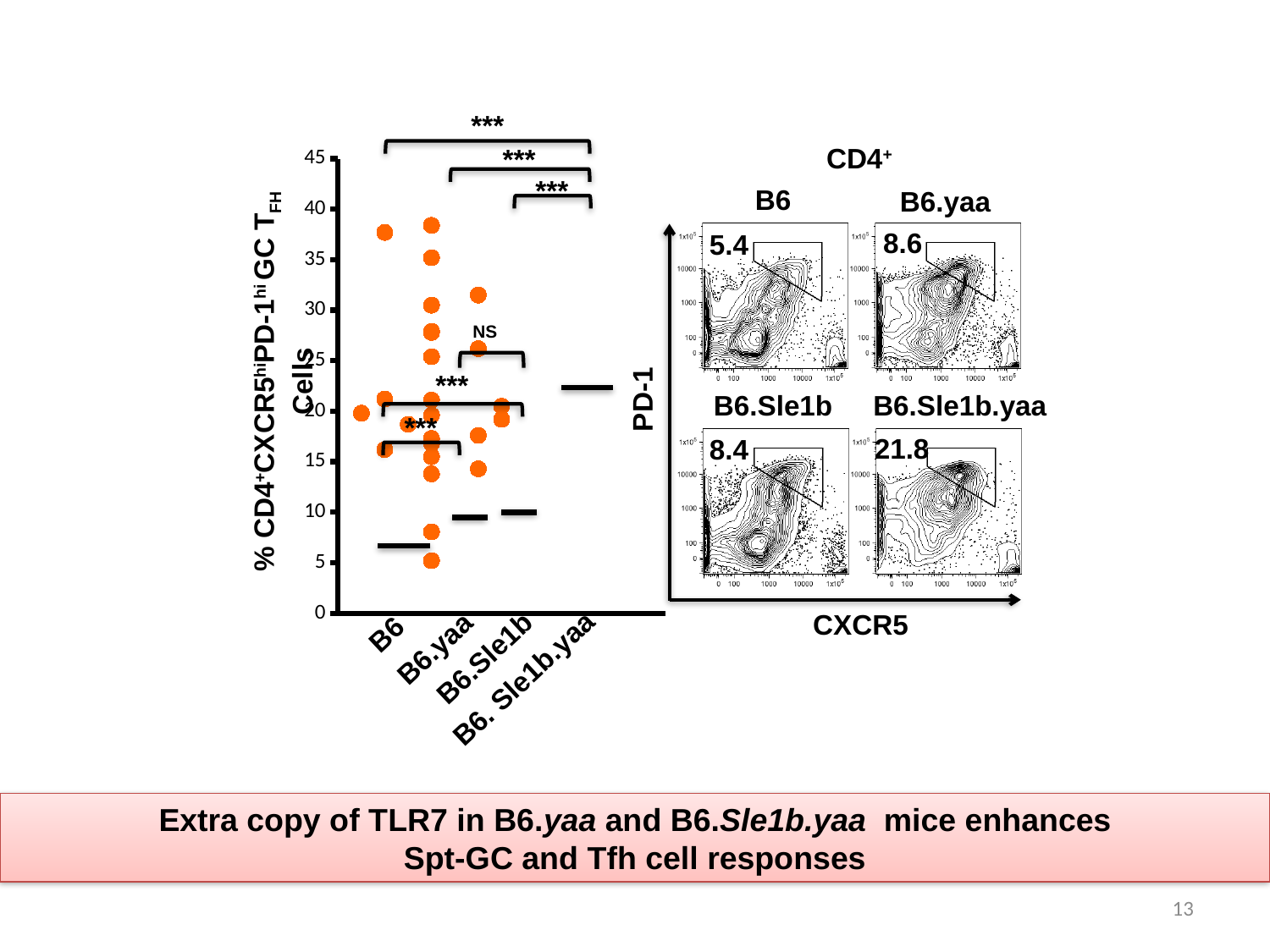
Among the four flow cytometry panels on the right, which mouse strain has the lowest gated percentage? B6 How many mouse strains are plotted along the x axis of the dot plot on the left? 4 In the dot plot on the left, what significance label is shown for the comparison between B6.yaa and B6.Sle1b? NS In the flow cytometry panels on the right, which has the larger gated percentage, B6.yaa or B6.Sle1b? B6.yaa In the flow cytometry panels on the right, what percentage is shown in the gate for B6 mice? 5.4 In the flow cytometry panels on the right, what percentage is shown in the gate for B6.Sle1b.yaa mice? 21.8 In the flow cytometry panels on the right, what percentage is shown in the gate for B6.yaa mice? 8.6 In the flow cytometry panels on the right, what is the difference between the gated percentages for B6.Sle1b.yaa and B6? 16.4 Among the four flow cytometry panels on the right, which mouse strain has the highest gated percentage? B6.Sle1b.yaa What kind of chart is the plot on the left showing % CD4+CXCR5hiPD-1hi GC TFH cells? Scatter (dot) plot In the dot plot on the left, is the median line for B6.Sle1b.yaa greater or less than 20? greater In the flow cytometry panels on the right, what percentage is shown in the gate for B6.Sle1b mice? 8.4